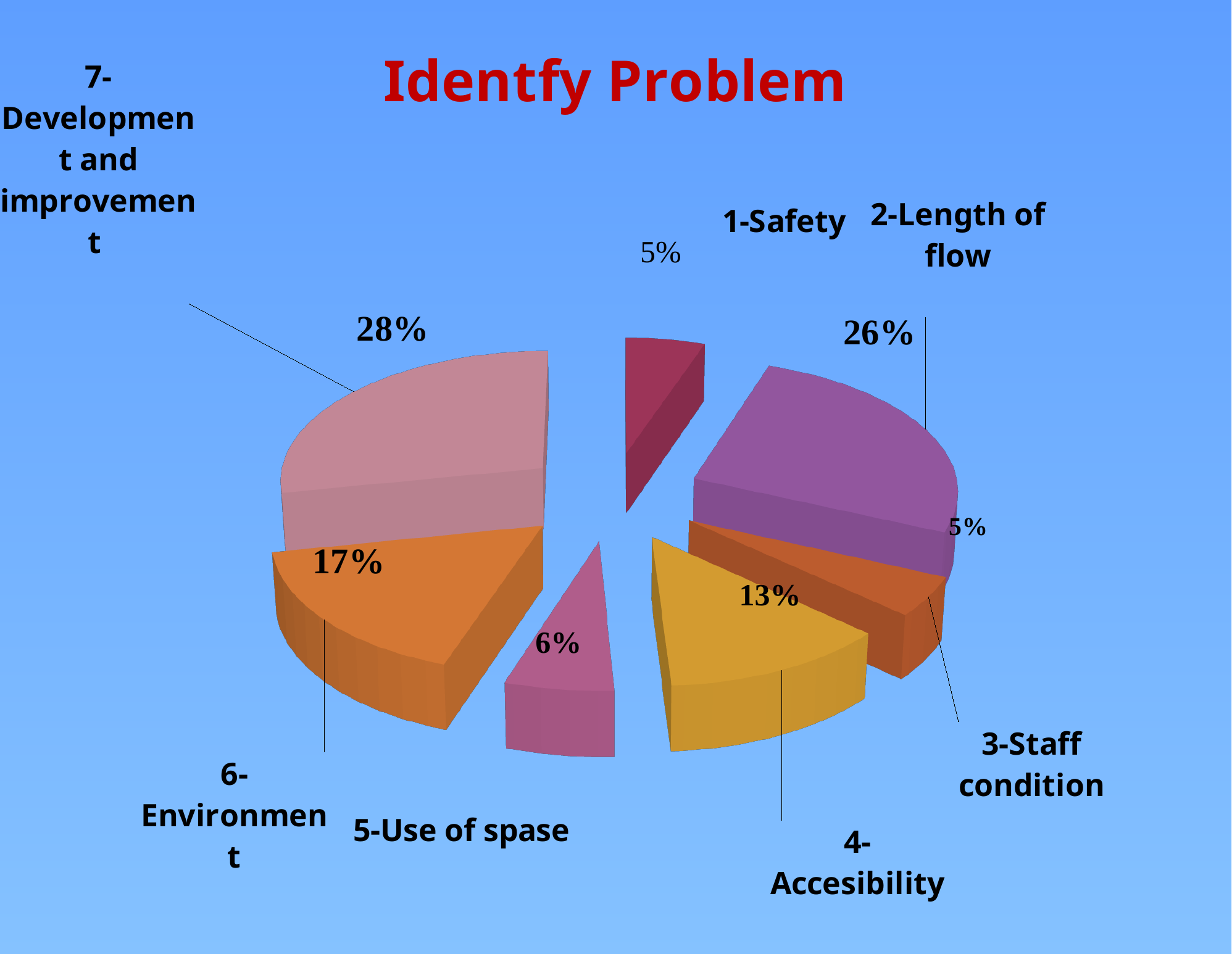
Which category has the largest share of the pie? 7-Development and improvement What is the difference in percentage points between 6-Environment and 5-Use of spase? 11 What percentage is shown for 7-Development and improvement? 28% What percentage is shown for 5-Use of spase? 6% What percentage is shown for 2-Length of flow? 26% How many slices does the pie chart have? 7 What kind of chart is shown on the slide? Pie chart Which is larger, 6-Environment or 4-Accesibility? 6-Environment What is the difference in percentage points between 7-Development and improvement and 2-Length of flow? 2 What percentage is shown for 6-Environment? 17% What percentage is shown for 4-Accesibility? 13% What is the title of the chart? Identfy Problem